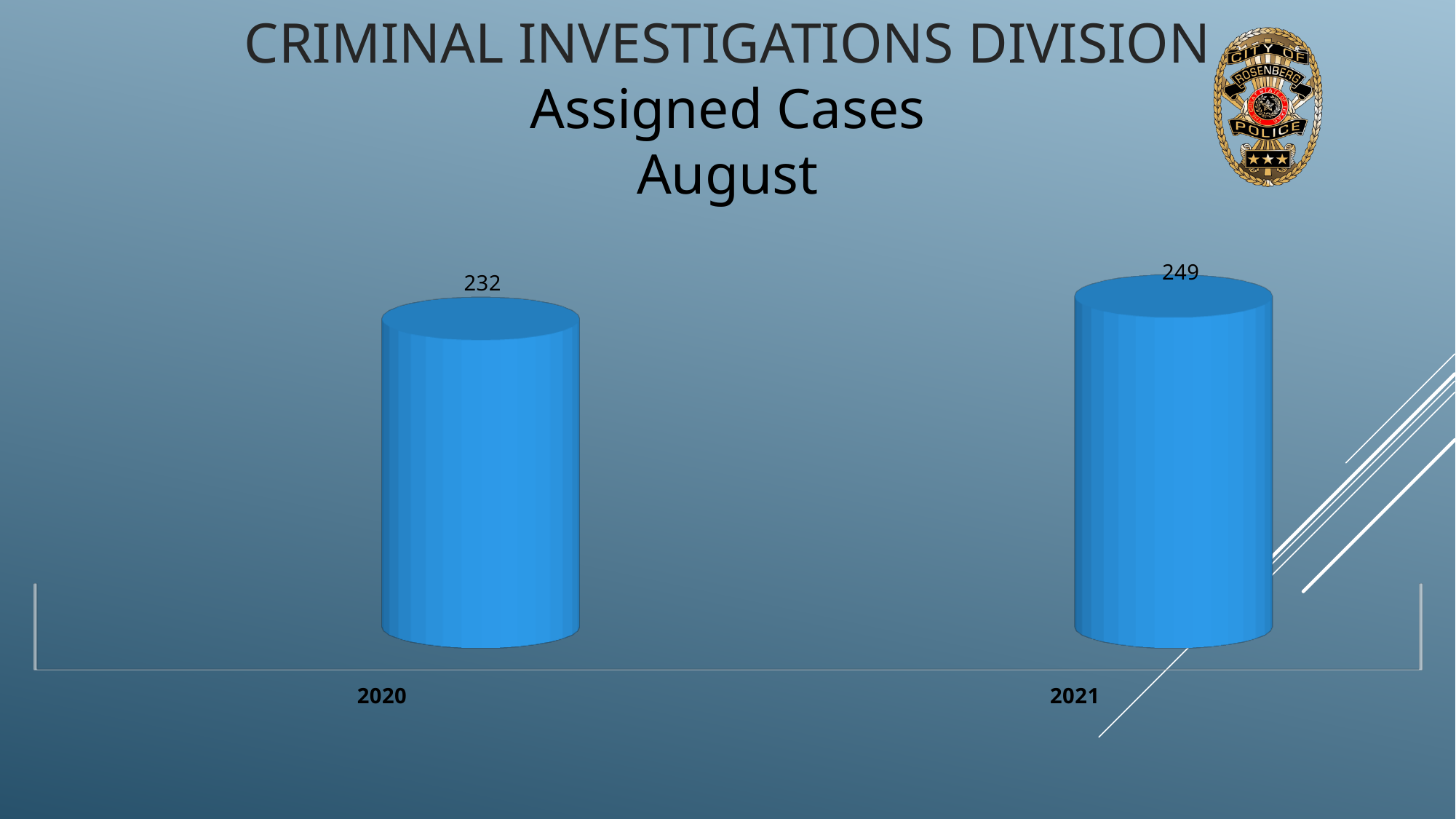
Which year has the higher number of assigned cases? 2021 Is the value for 2021 larger or smaller than the value for 2020? larger What kind of chart is shown on the slide? bar chart Which month do the assigned cases on the slide refer to? August What is the number of assigned cases for 2020? 232 What is the difference in assigned cases between 2021 and 2020? 17 What is the total of assigned cases across both years shown? 481 What is the number of assigned cases for 2021? 249 Which year has the lower number of assigned cases? 2020 How many years are shown on the chart? 2 Do the assigned cases rise or fall from 2020 to 2021? rise Which division's assigned cases does the slide show? Criminal Investigations Division